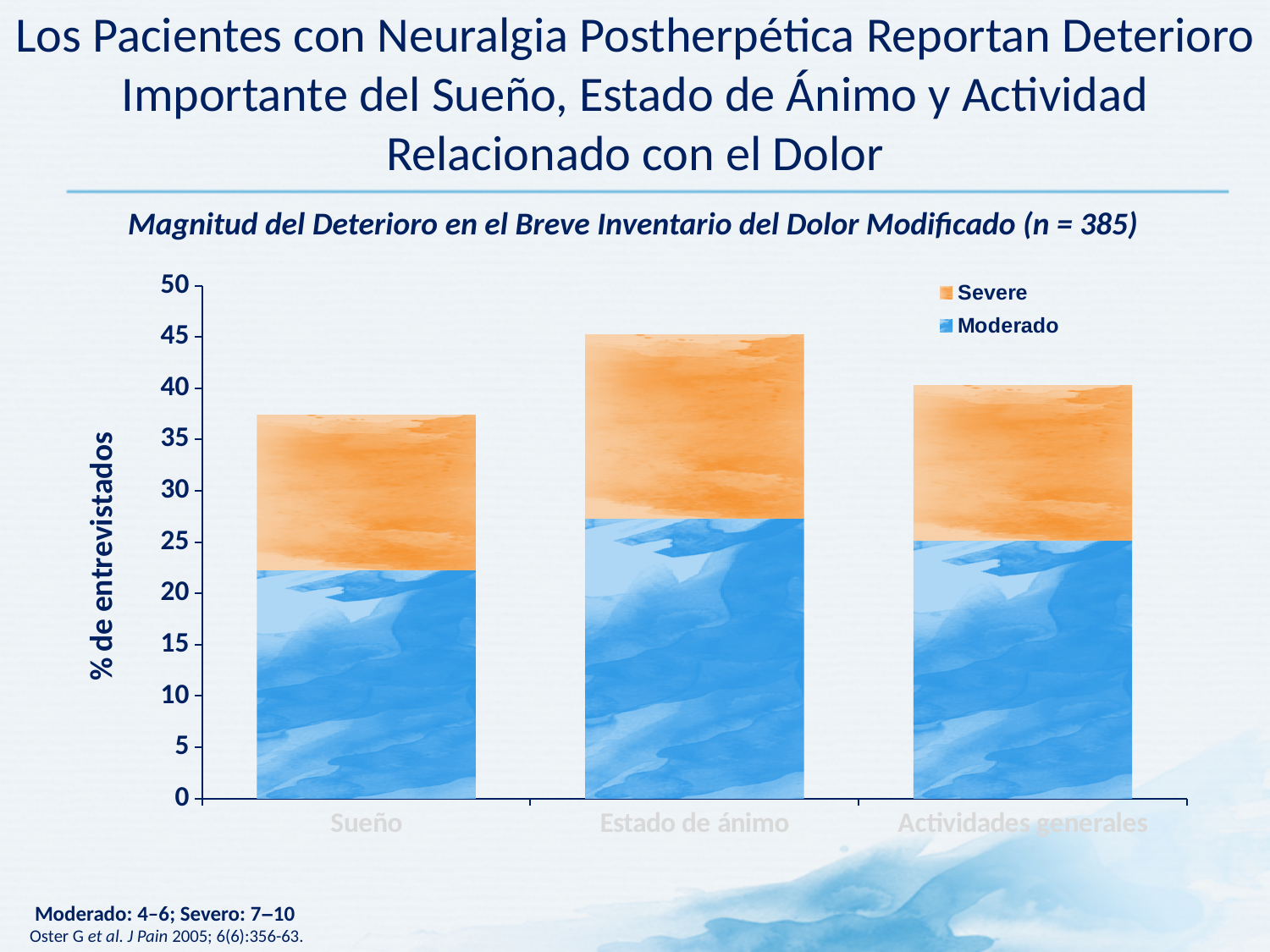
What kind of chart is shown on the slide? stacked bar chart Is the Moderado value for Actividades generales greater or less than 30? less Is the total bar for Estado de ánimo greater or less than 40? greater How many series does the chart's legend list? 2 What is the label of the y axis? % de entrevistados Which category has the highest total bar? Estado de ánimo Which has a larger Moderado value, Sueño or Estado de ánimo? Estado de ánimo Is the total bar for Actividades generales greater or less than 45? less Which category has the lowest total bar? Sueño How many categories are shown on the x axis of the chart? 3